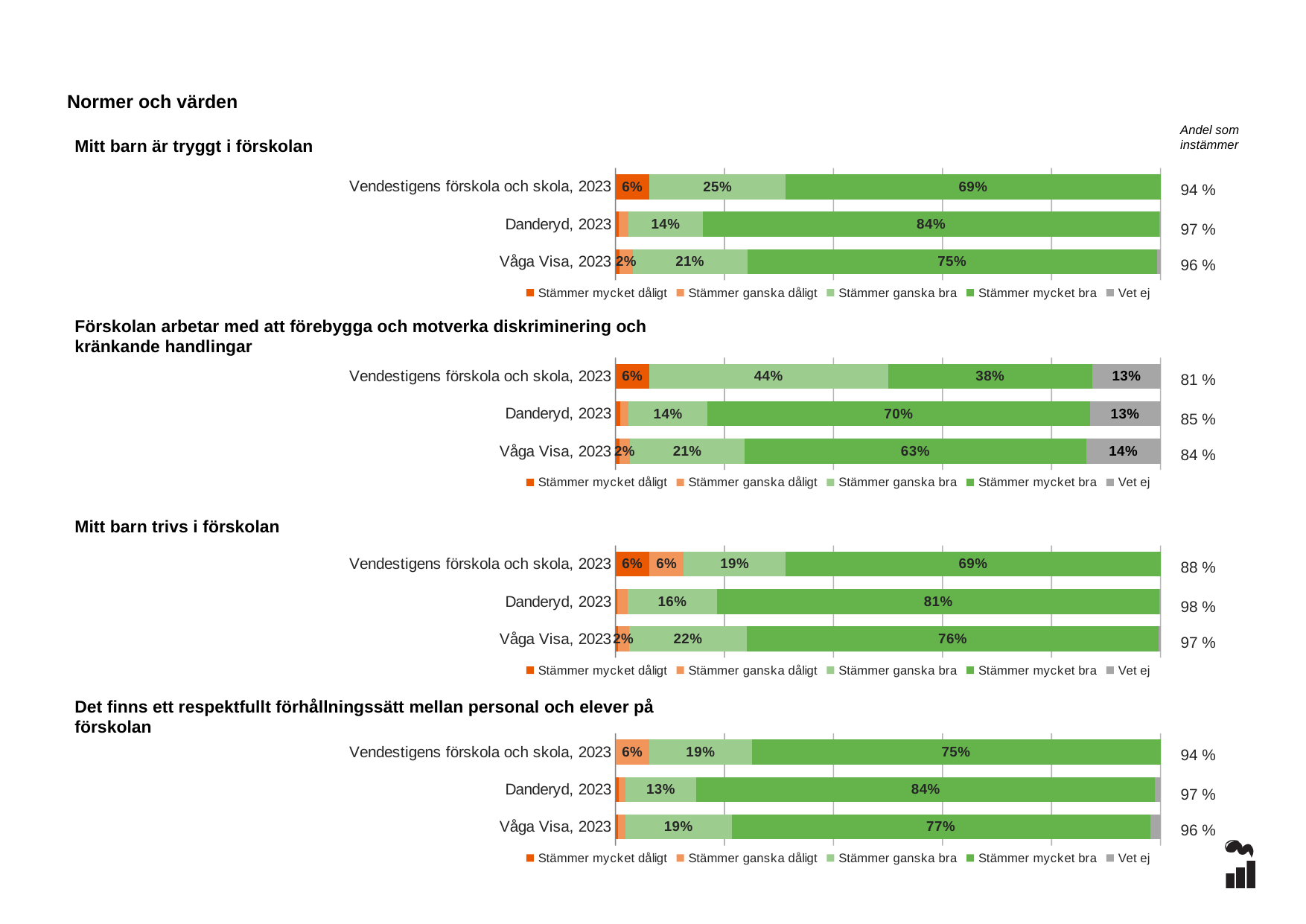
In the chart 'Mitt barn trivs i förskolan', which row has the lowest 'Stämmer mycket bra' value? Vendestigens förskola och skola, 2023 What kind of chart is used for 'Mitt barn är tryggt i förskolan'? Stacked horizontal bar chart In the chart 'Förskolan arbetar med att förebygga och motverka diskriminering och kränkande handlingar', what is the 'Andel som instämmer' value for Vendestigens förskola och skola, 2023? 81 % In the chart 'Förskolan arbetar med att förebygga och motverka diskriminering och kränkande handlingar', which row has the highest 'Stämmer mycket bra' value? Danderyd, 2023 In the chart 'Det finns ett respektfullt förhållningssätt mellan personal och elever på förskolan', what is the 'Stämmer ganska bra' value for Danderyd, 2023? 13% In the chart 'Mitt barn är tryggt i förskolan', what is the 'Stämmer ganska bra' value for Vendestigens förskola och skola, 2023? 25% How many series does the legend of the chart 'Mitt barn trivs i förskolan' list? 5 In the chart 'Det finns ett respektfullt förhållningssätt mellan personal och elever på förskolan', which is larger: the 'Stämmer mycket bra' value for Danderyd, 2023 or for Våga Visa, 2023? Danderyd, 2023 In the chart 'Mitt barn trivs i förskolan', what is the difference between the 'Stämmer mycket bra' values for Danderyd, 2023 and Vendestigens förskola och skola, 2023? 12 percentage points In the chart 'Förskolan arbetar med att förebygga och motverka diskriminering och kränkande handlingar', what is the 'Vet ej' value for Våga Visa, 2023? 14% How many rows (categories) does the chart 'Mitt barn är tryggt i förskolan' show? 3 In the chart 'Mitt barn är tryggt i förskolan', what is the 'Stämmer mycket bra' value for Danderyd, 2023? 84%